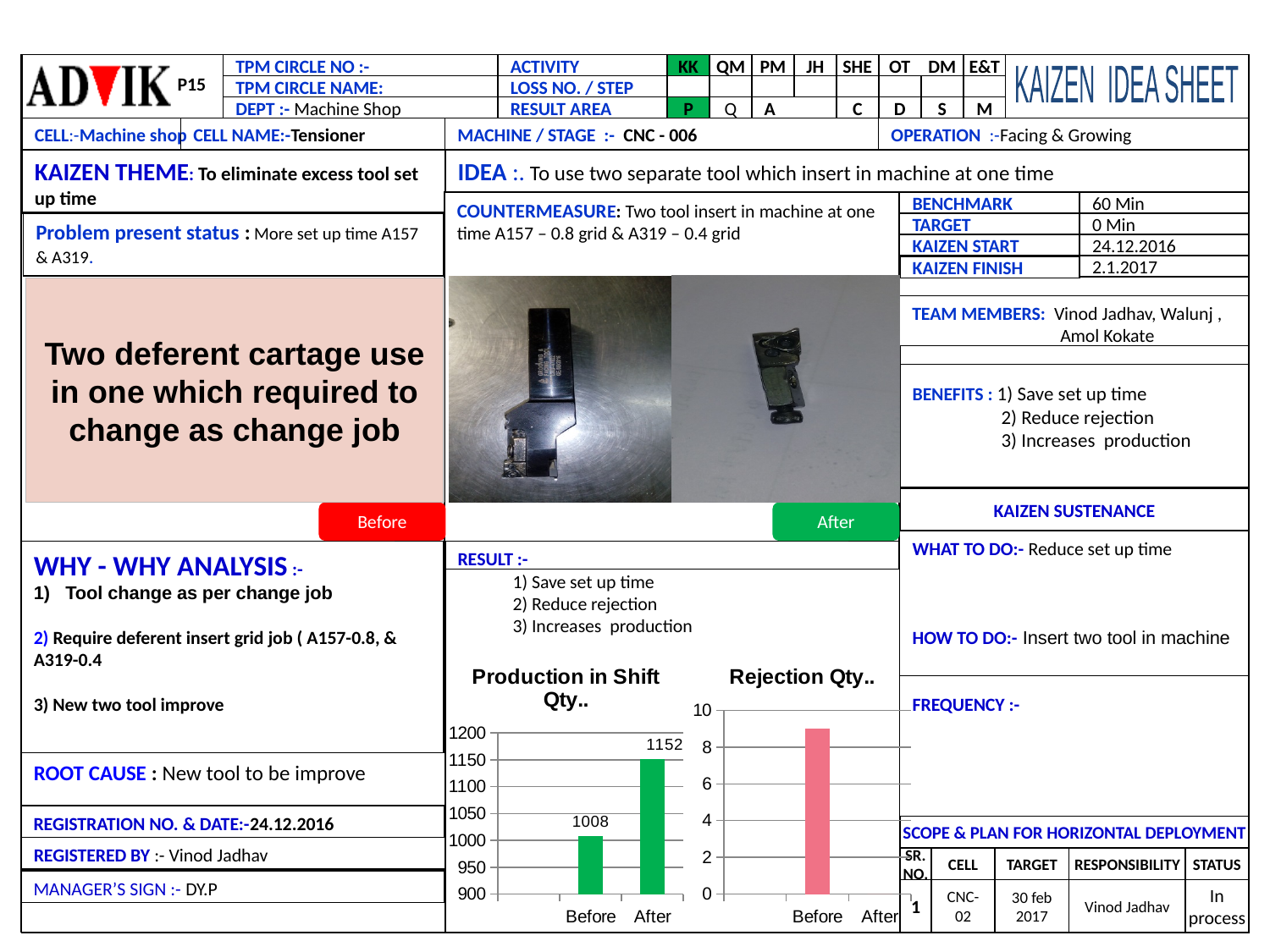
In the 'Production in Shift Qty..' chart, what is the difference between the After and Before values? 144 In the 'Production in Shift Qty..' chart, which category has the higher value? After What kind of chart is the 'Rejection Qty..' chart? bar chart In the 'Rejection Qty..' chart, which category has the higher value? Before In the 'Production in Shift Qty..' chart, what is the value for After? 1152 What is the title of the chart on the right of the two charts? Rejection Qty.. In the 'Rejection Qty..' chart, is the value for Before greater or less than 10? less In the 'Production in Shift Qty..' chart, do the values rise or fall from Before to After? rise In the 'Production in Shift Qty..' chart, how many categories are shown on the x axis? 2 What kind of chart is the 'Production in Shift Qty..' chart? bar chart In the 'Rejection Qty..' chart, is the value for Before greater or less than 8? greater In the 'Production in Shift Qty..' chart, what is the value for Before? 1008